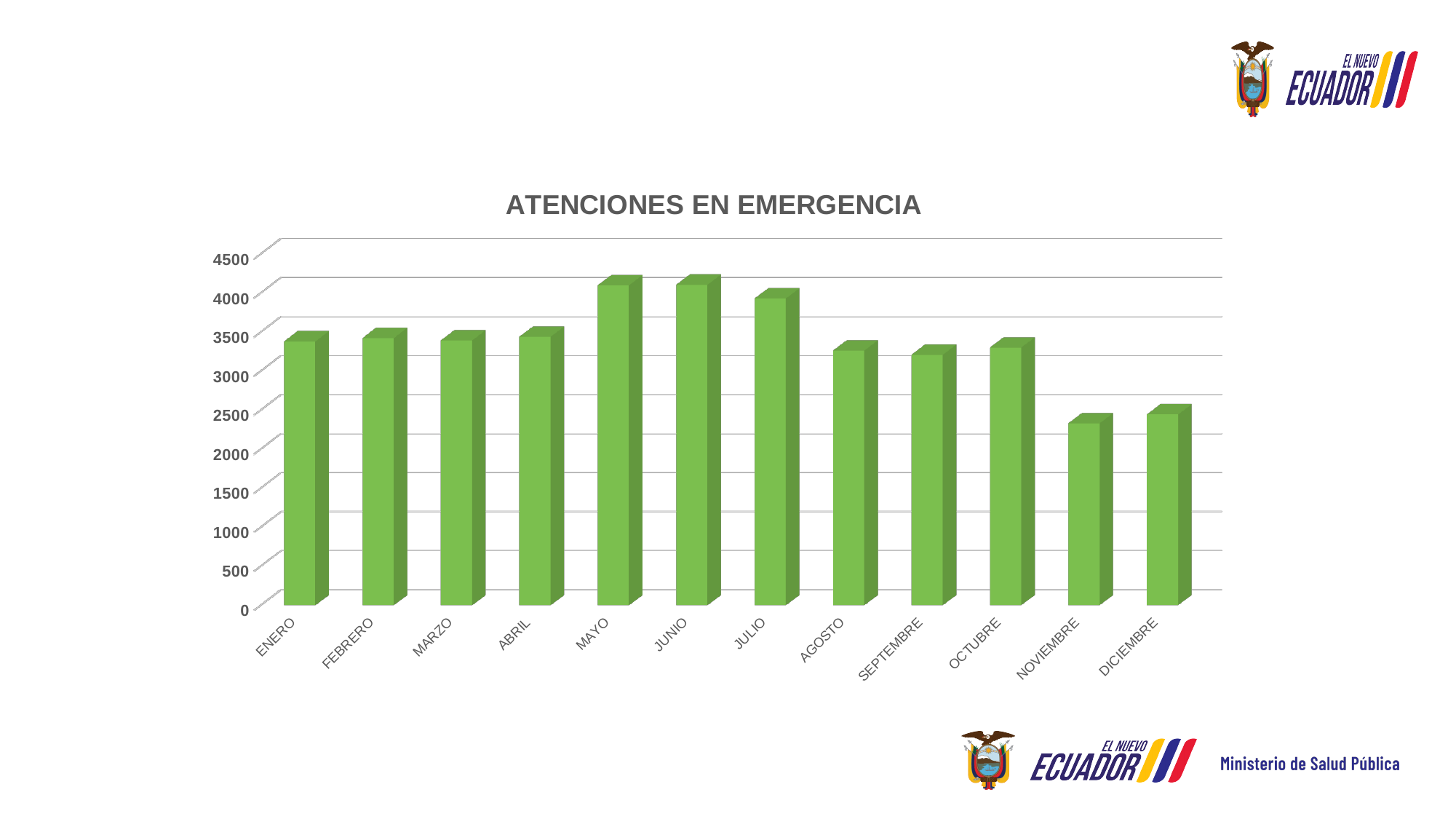
Is the value for MAYO greater or less than 4000? greater Is the value for AGOSTO greater or less than 3500? less Which month has the lowest value in the chart? NOVIEMBRE Is the value for NOVIEMBRE greater or less than 3000? less What kind of chart is shown on the slide? bar chart Which is larger, the value for JULIO or the value for AGOSTO? JULIO What is the title of the chart? ATENCIONES EN EMERGENCIA How many months are shown on the x axis of the chart? 12 Do the values rise or fall from OCTUBRE to NOVIEMBRE? fall Which is larger, the value for MAYO or the value for NOVIEMBRE? MAYO